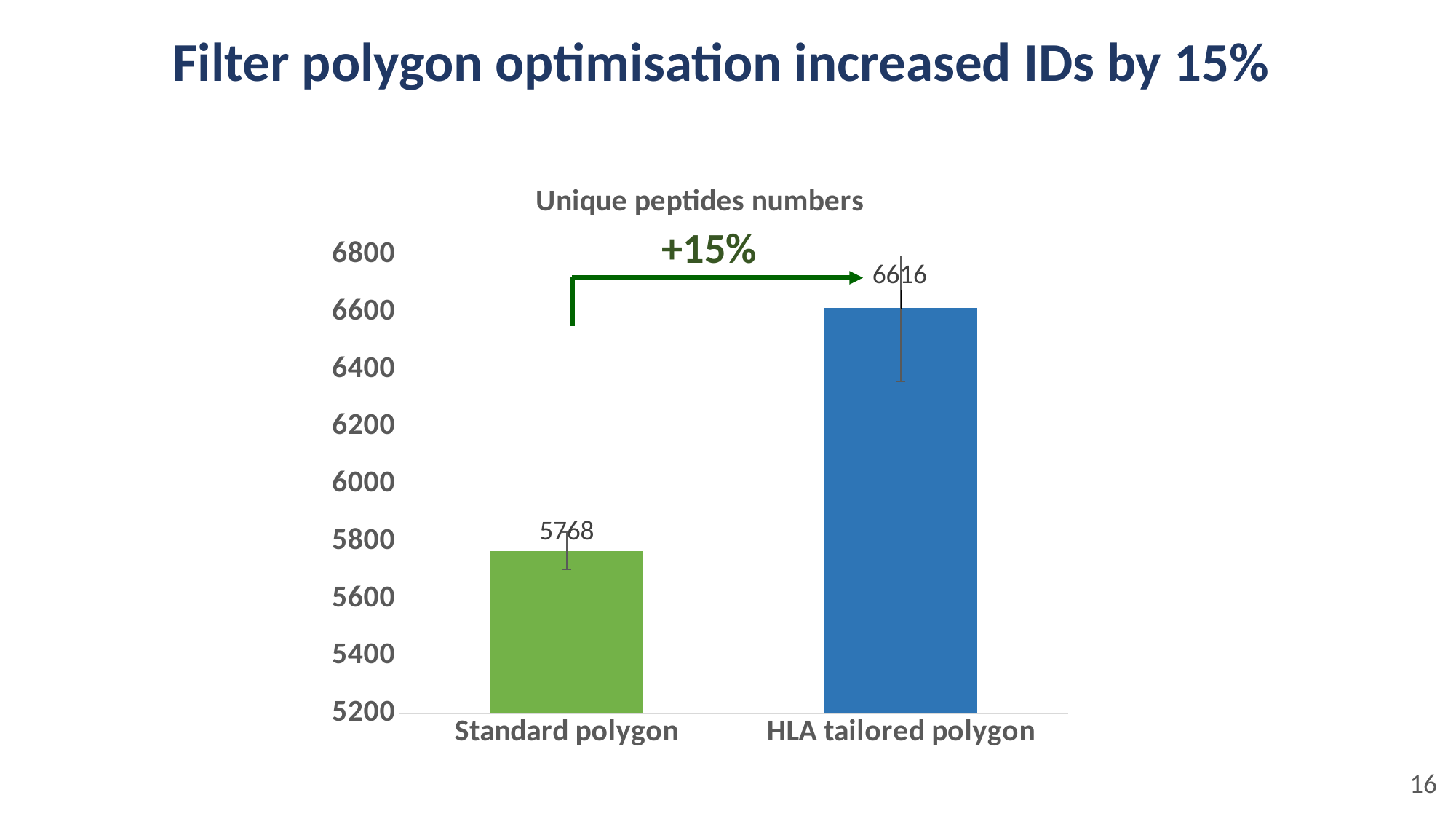
What is the title of the chart? Unique peptides numbers What kind of chart is shown on the slide? bar chart What percentage increase is annotated above the bars? +15% What is the difference between the HLA tailored polygon and Standard polygon values? 848 What is the value for HLA tailored polygon? 6616 Is the value for Standard polygon greater or less than 6000? less Which category has the highest value? HLA tailored polygon Which category has the lowest value? Standard polygon How many categories are shown on the x axis? 2 Which is larger, the value for Standard polygon or HLA tailored polygon? HLA tailored polygon Is the value for HLA tailored polygon greater or less than 6400? greater What is the value for Standard polygon? 5768